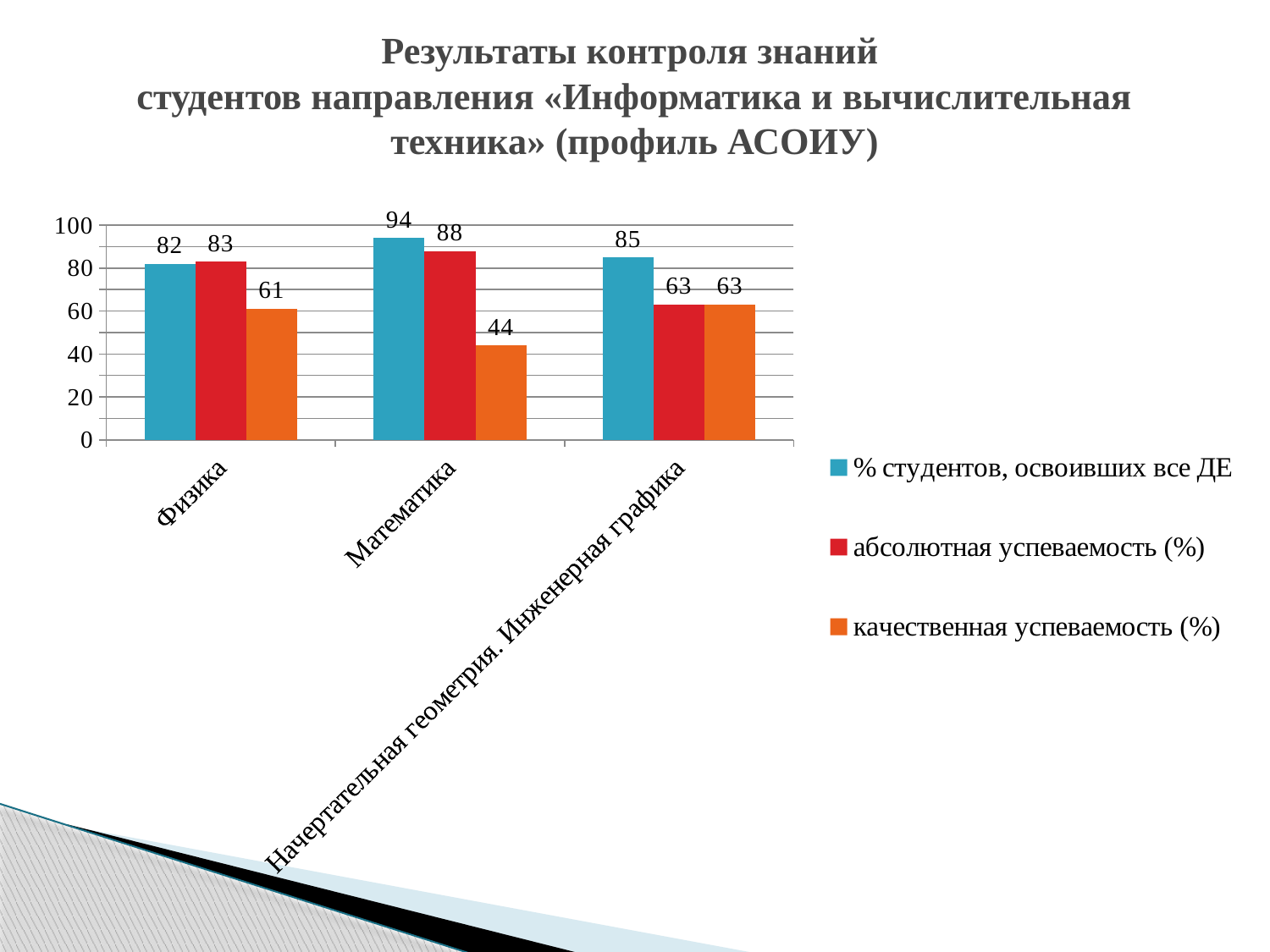
What is the difference between «абсолютная успеваемость (%)» and «качественная успеваемость (%)» for Математика? 44 What is the value of «% студентов, освоивших все ДЕ» for Математика? 94 Which category has the lowest value for «качественная успеваемость (%)»? Математика Is the value of «качественная успеваемость (%)» for Математика greater or less than 60? less What is the value of «абсолютная успеваемость (%)» for Начертательная геометрия. Инженерная графика? 63 How many categories are shown on the x axis? 3 Which category has the highest value for «% студентов, освоивших все ДЕ»? Математика What kind of chart is shown on the slide? bar chart What is the value of «качественная успеваемость (%)» for Физика? 61 Which colour represents «качественная успеваемость (%)» in the legend? orange How many series does the legend list? 3 Which is larger for Физика: «% студентов, освоивших все ДЕ» or «абсолютная успеваемость (%)»? абсолютная успеваемость (%)